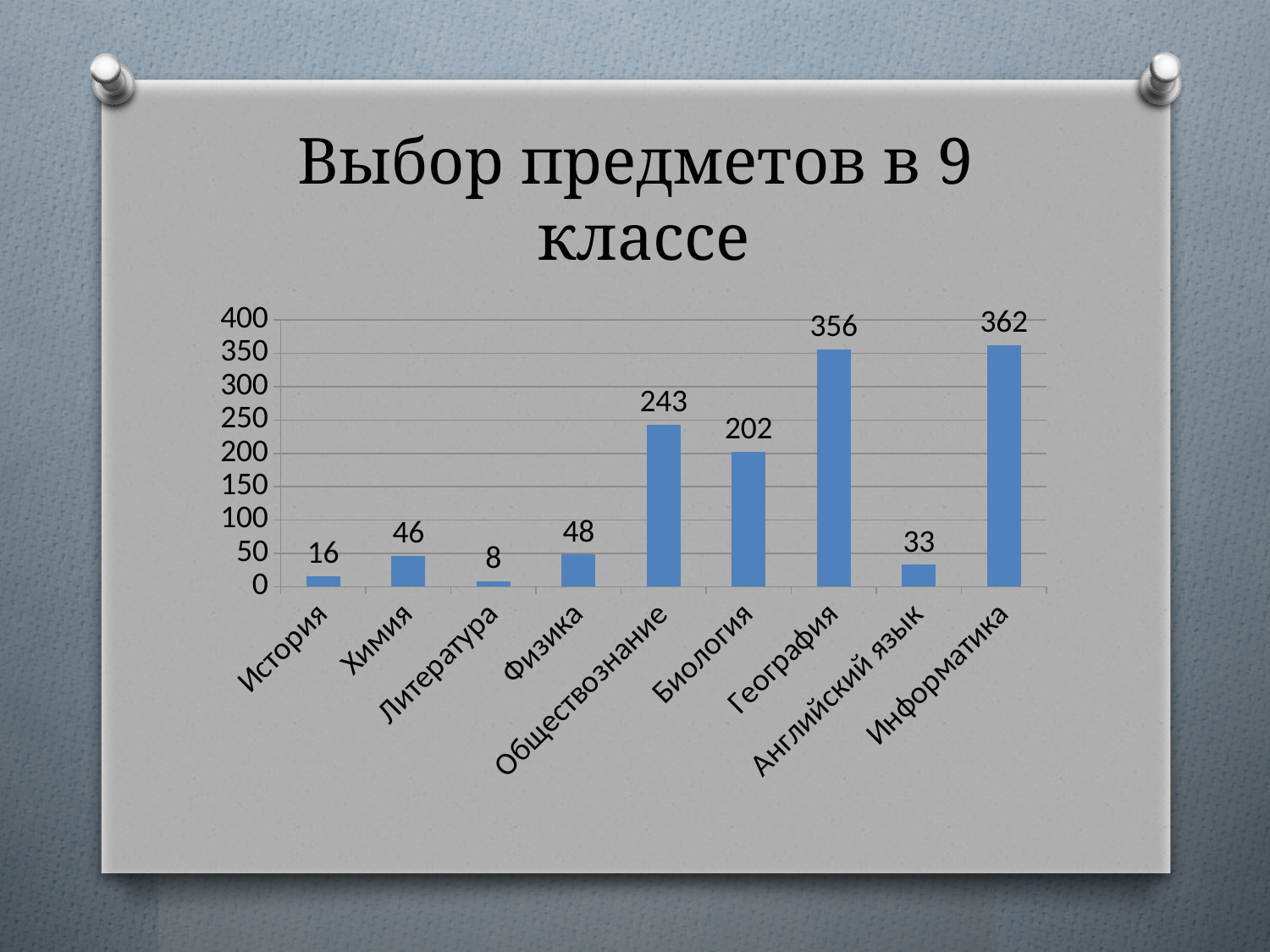
How many subjects are shown on the chart? 9 What is the value for Обществознание? 243 What kind of chart is shown on the slide? bar chart What is the value for История? 16 Which is larger, the value for Химия or the value for Физика? Физика What is the value for Английский язык? 33 What is the difference between the values for Информатика and География? 6 Which subject has the lowest value? Литература Is the value for Биология greater or less than 150? greater Which subject has the highest value? Информатика What is the title of the slide? Выбор предметов в 9 классе What is the difference between the values for Обществознание and Биология? 41